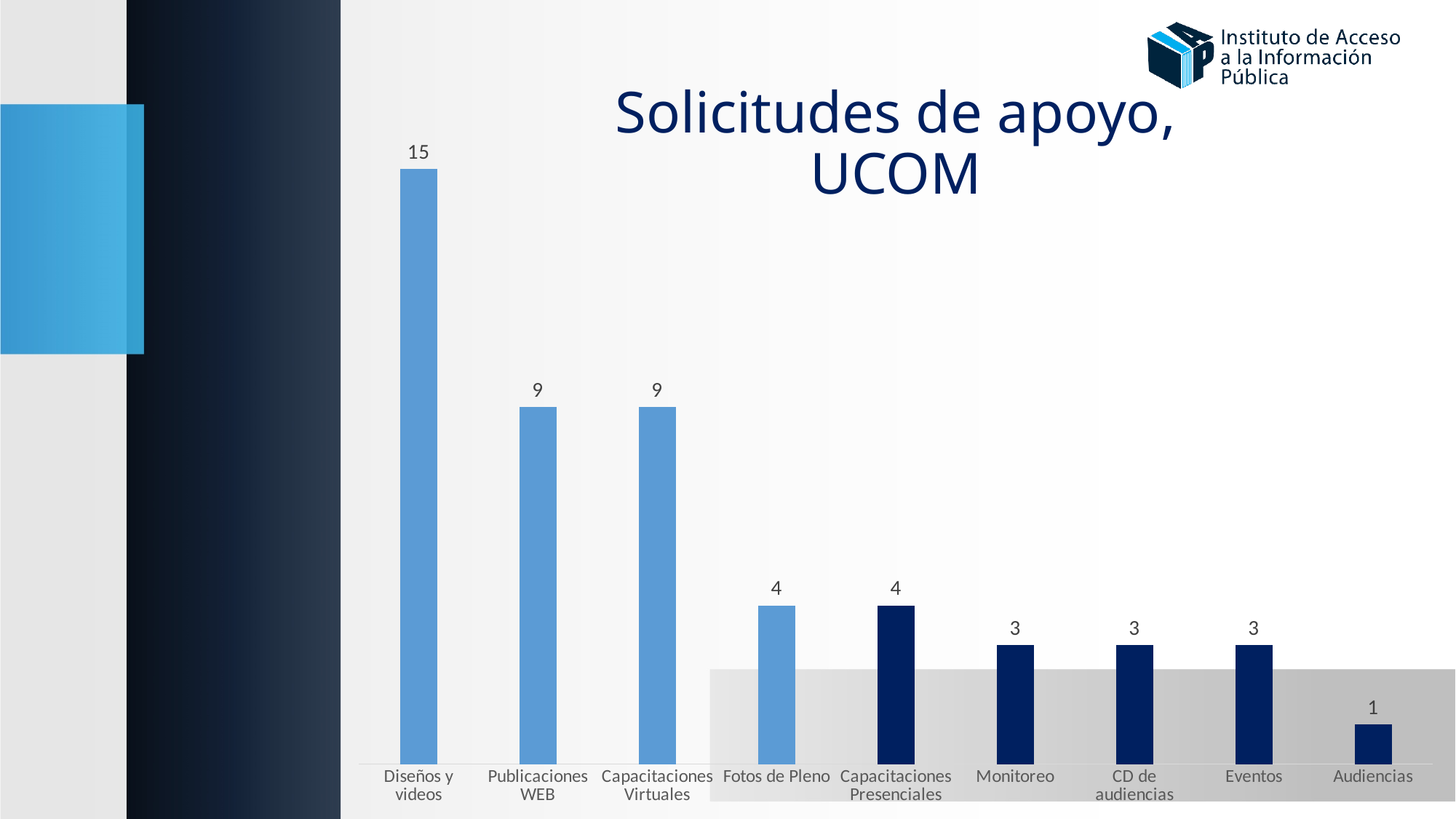
What kind of chart is shown on the slide? Bar chart What is the value for Monitoreo? 3 How many categories are shown in the chart? 9 Which category has the lowest value? Audiencias What is the value for Audiencias? 1 What is the value for Diseños y videos? 15 Which is larger, the value for Fotos de Pleno or the value for Eventos? Fotos de Pleno What is the title of the chart? Solicitudes de apoyo, UCOM Which category has the highest value? Diseños y videos What is the difference between the values for Diseños y videos and Capacitaciones Virtuales? 6 Do the values rise or fall from left to right along the x axis? Fall What is the value for Publicaciones WEB? 9